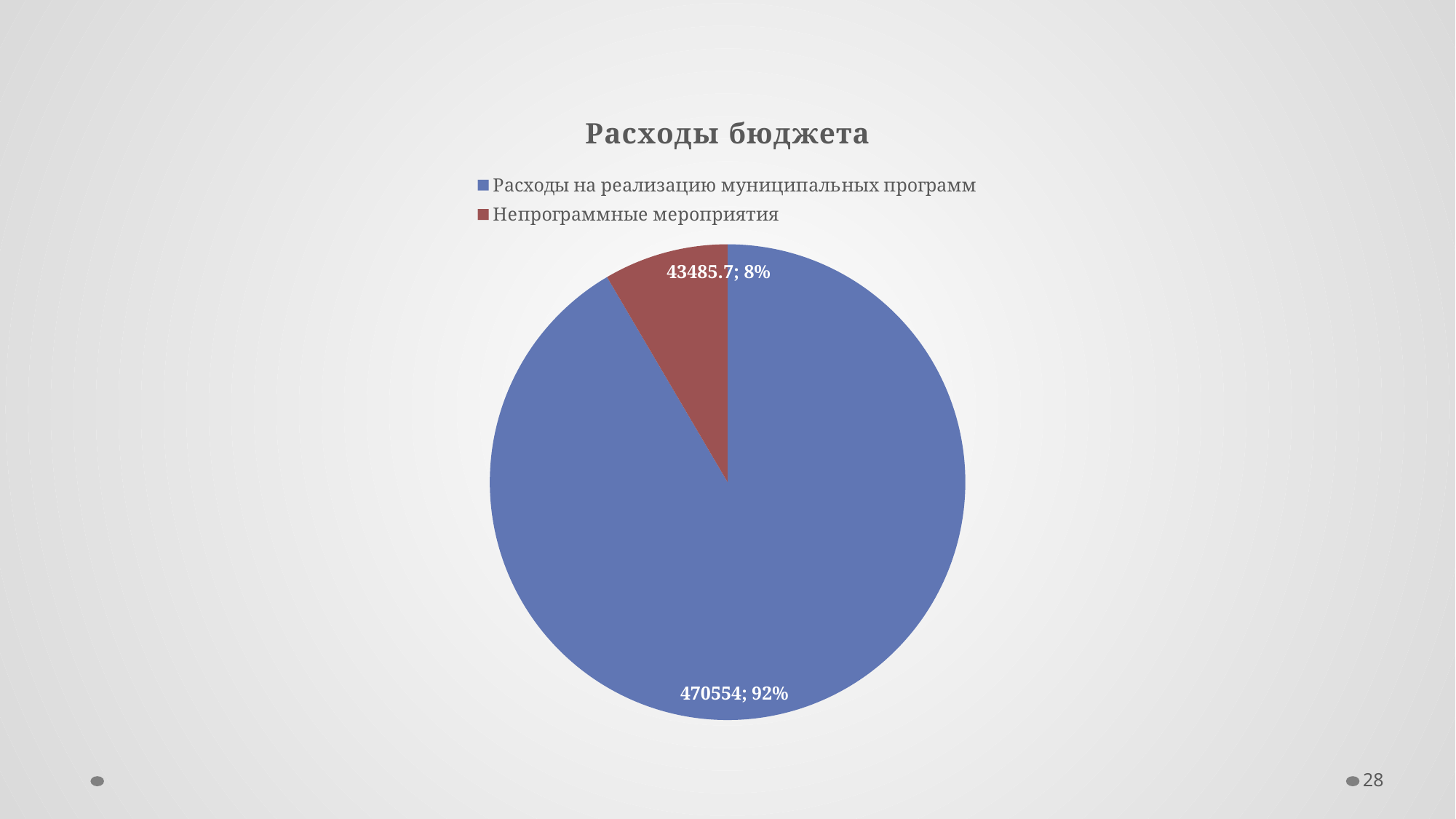
Which colour represents Непрограммные мероприятия in the chart? red What kind of chart is shown on the slide? pie chart What share of the pie does Непрограммные мероприятия take? 8% What is the value for Непрограммные мероприятия? 43485.7 Which category has the largest slice? Расходы на реализацию муниципальных программ What is the difference between the values for Расходы на реализацию муниципальных программ and Непрограммные мероприятия? 427068.3 What share of the pie does Расходы на реализацию муниципальных программ take? 92% What is the title of the chart? Расходы бюджета How many slices does the pie chart have? 2 Which category has the smallest slice? Непрограммные мероприятия How many entries does the legend list? 2 What is the value for Расходы на реализацию муниципальных программ? 470554